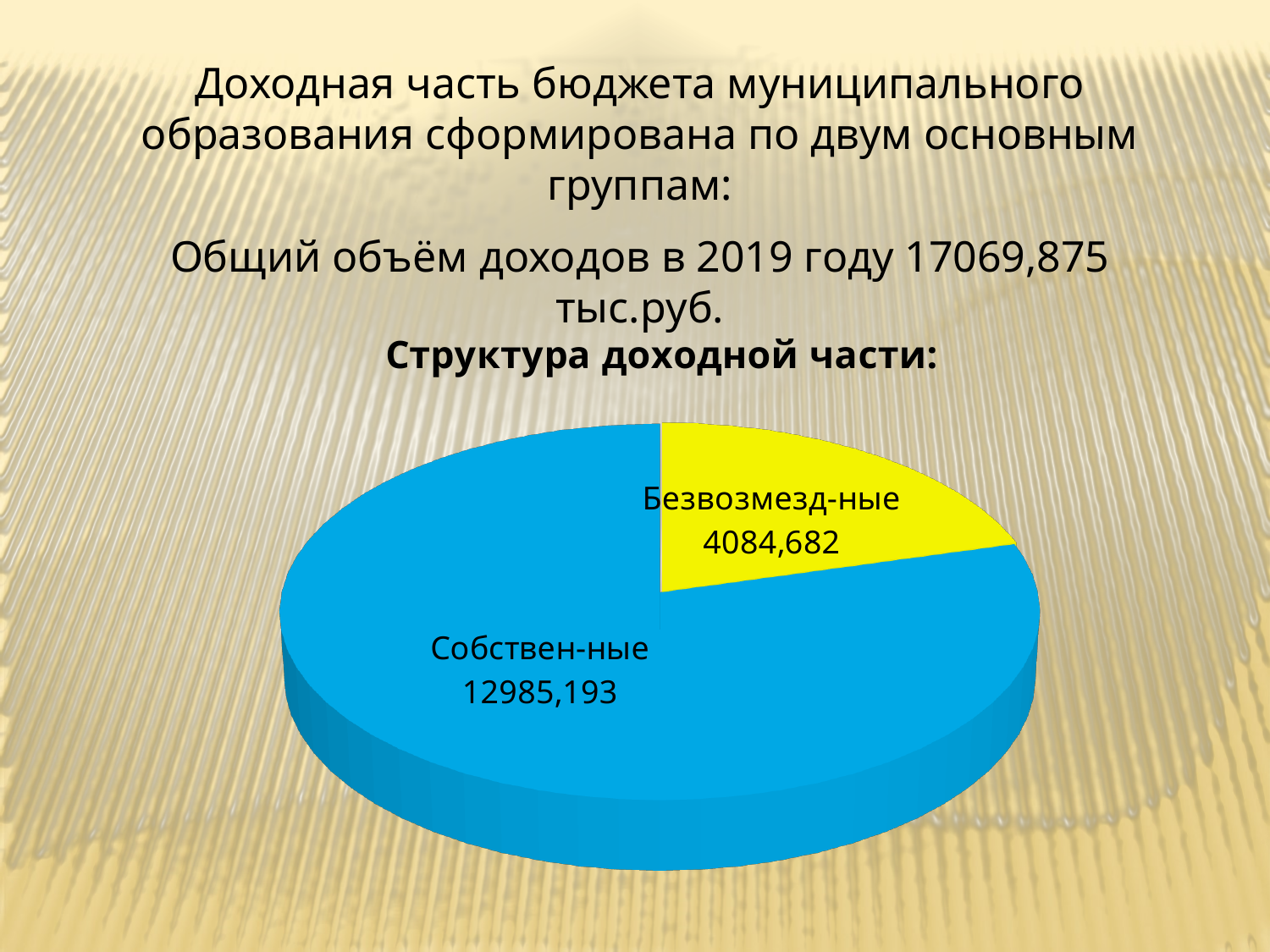
Which is larger, Собствен-ные or Безвозмезд-ные? Собствен-ные What colour is the Собствен-ные slice? Blue Which category has the largest slice of the pie? Собствен-ные What kind of chart is shown on the slide? Pie chart What colour is the Безвозмезд-ные slice? Yellow What is the total of the two slices in the pie chart? 17069,875 How many slices does the pie chart have? 2 What is the value for the Безвозмезд-ные slice? 4084,682 What is the value for the Собствен-ные slice? 12985,193 What is the difference between the Собствен-ные and Безвозмезд-ные values? 8900,511 Which category has the smallest slice of the pie? Безвозмезд-ные